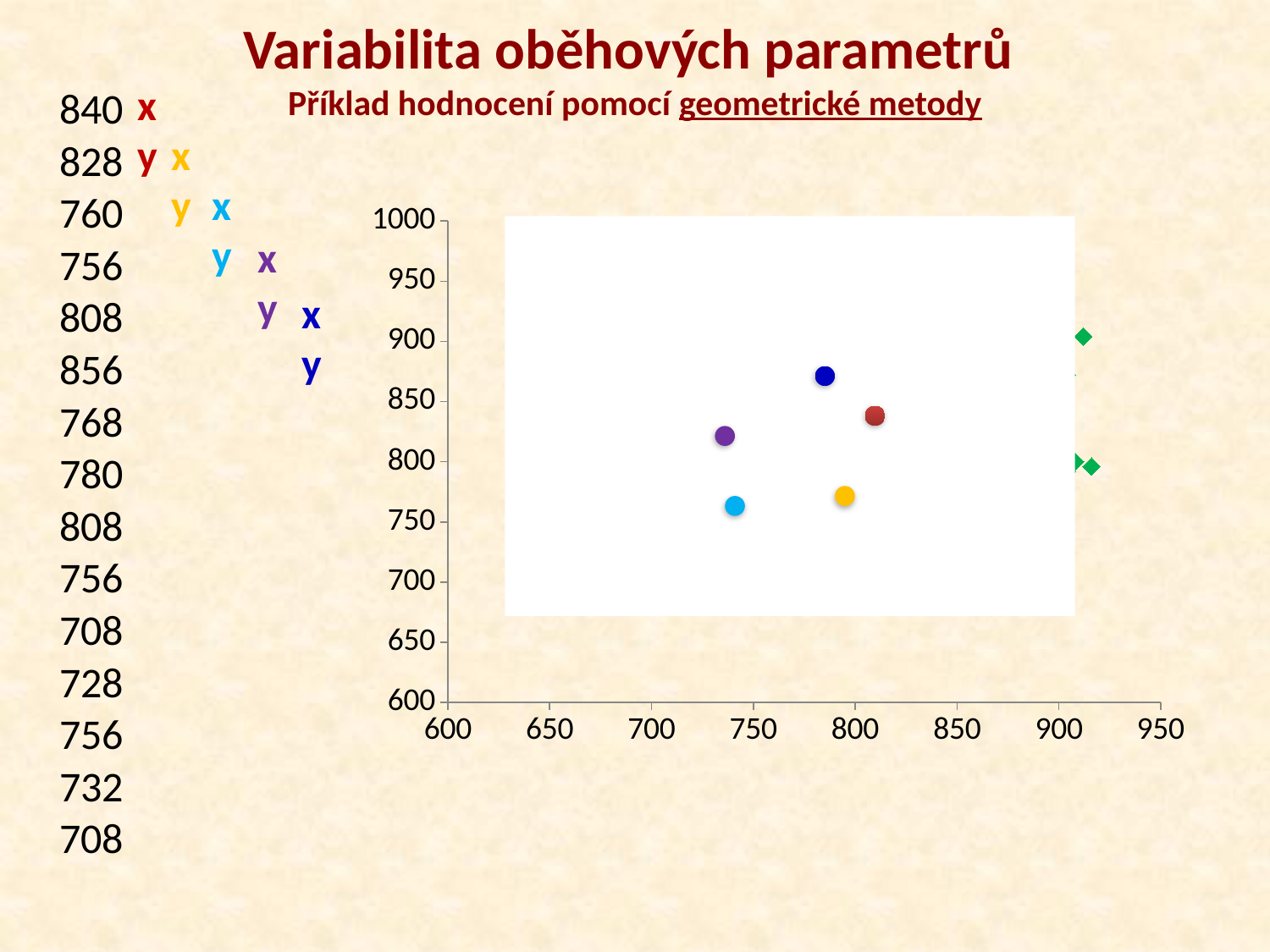
How many large circular markers are plotted on the chart? 5 Which circular point has the highest vertical (y) value? the dark blue point What kind of chart is shown on the slide? scatter chart Which has the larger horizontal (x) value, the red point or the light blue point? the red point Is the vertical (y) value of the dark blue point greater or less than 850? greater Is the vertical (y) value of the yellow point greater or less than 800? less Which has the higher vertical (y) value, the dark blue point or the yellow point? the dark blue point Is the horizontal (x) value of the red point greater or less than 800? greater What is the highest value shown on the vertical axis? 1000 What is the lowest value shown on the horizontal axis? 600